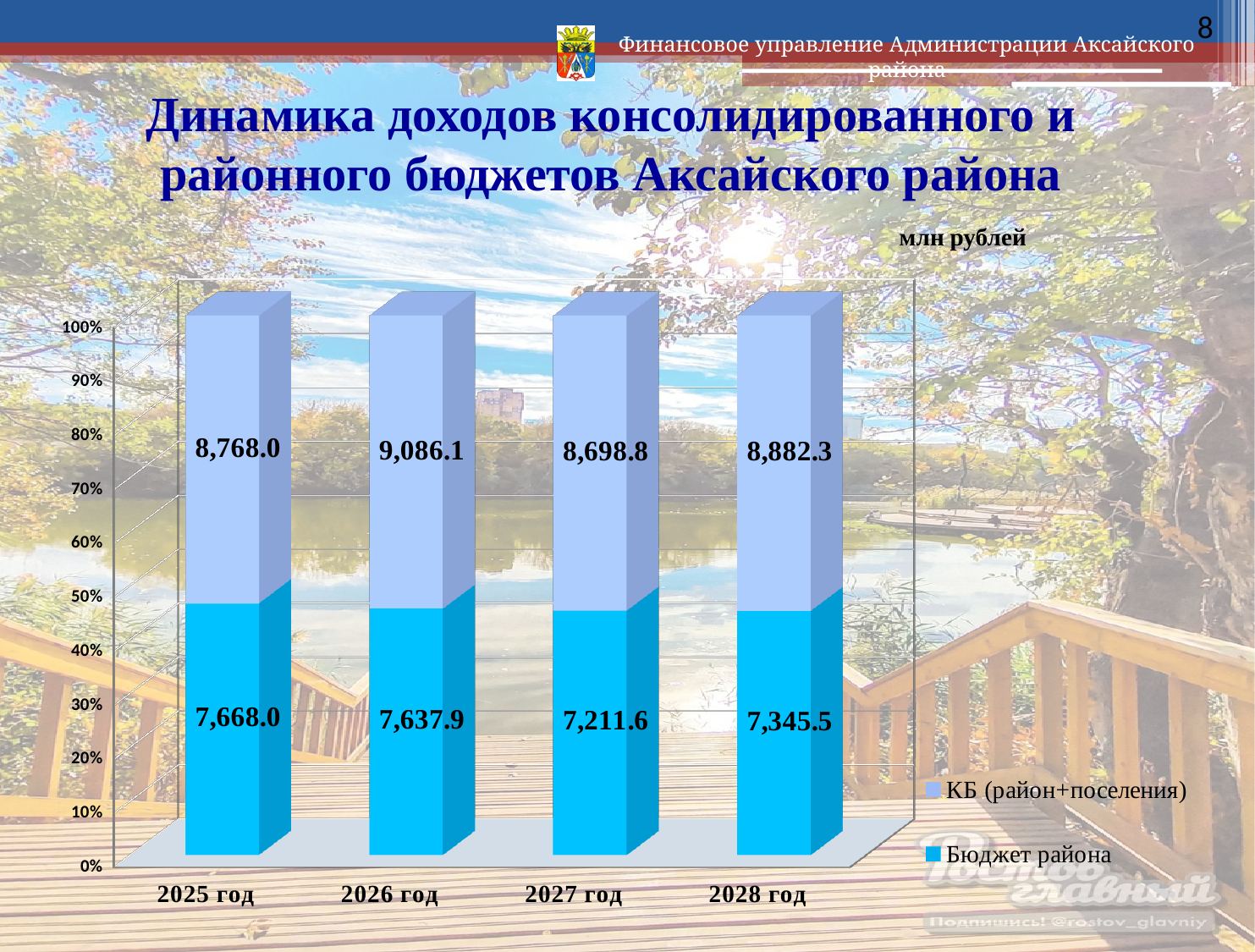
In which year is the value for КБ (район+поселения) the highest? 2026 год What kind of chart is shown on the slide? Stacked bar chart In which year is the value for Бюджет района the lowest? 2027 год What unit is stated above the chart? млн рублей What is the value for Бюджет района in 2027 год? 7,211.6 How many years are shown on the x axis? 4 What is the difference between the КБ (район+поселения) value and the Бюджет района value in 2025 год? 1,100.0 What is the value for Бюджет района in 2028 год? 7,345.5 What is the value for КБ (район+поселения) in 2025 год? 8,768.0 How many series does the legend list? 2 What is the value for КБ (район+поселения) in 2026 год? 9,086.1 Which is larger: the Бюджет района value in 2025 год or in 2026 год? 2025 год